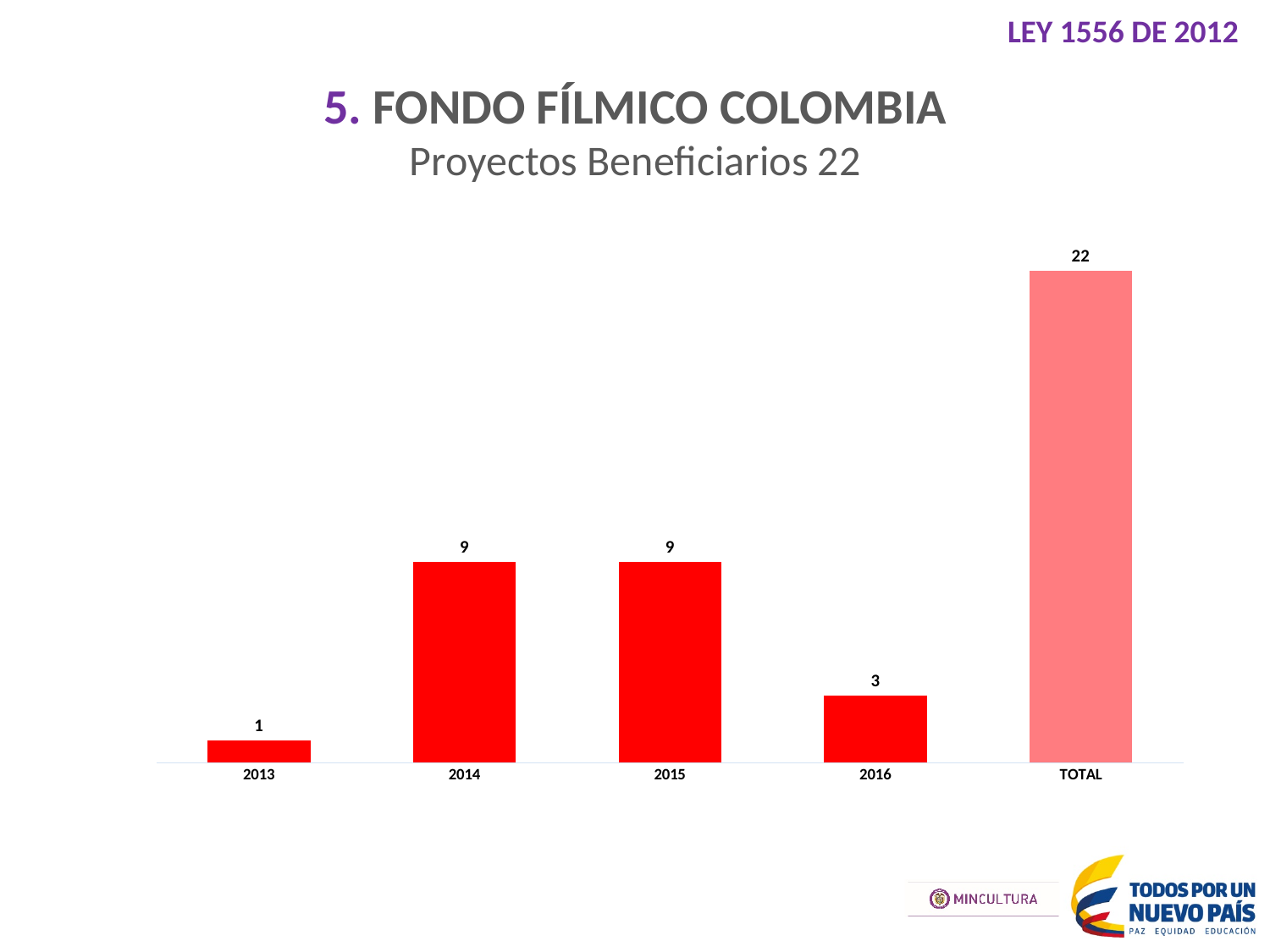
What is the value for 2016? 3 Which is larger, the value for 2014 or the value for 2016? 2014 What kind of chart is this? bar chart Which category has the highest bar? TOTAL Which year has the lowest value? 2013 Do the values rise or fall from 2015 to 2016? fall What is the value for 2013? 1 What is the value for 2014? 9 What is the title of the chart? 5. FONDO FÍLMICO COLOMBIA Proyectos Beneficiarios 22 What is the value for TOTAL? 22 What is the difference between the values for 2015 and 2016? 6 How many categories are shown on the x axis? 5